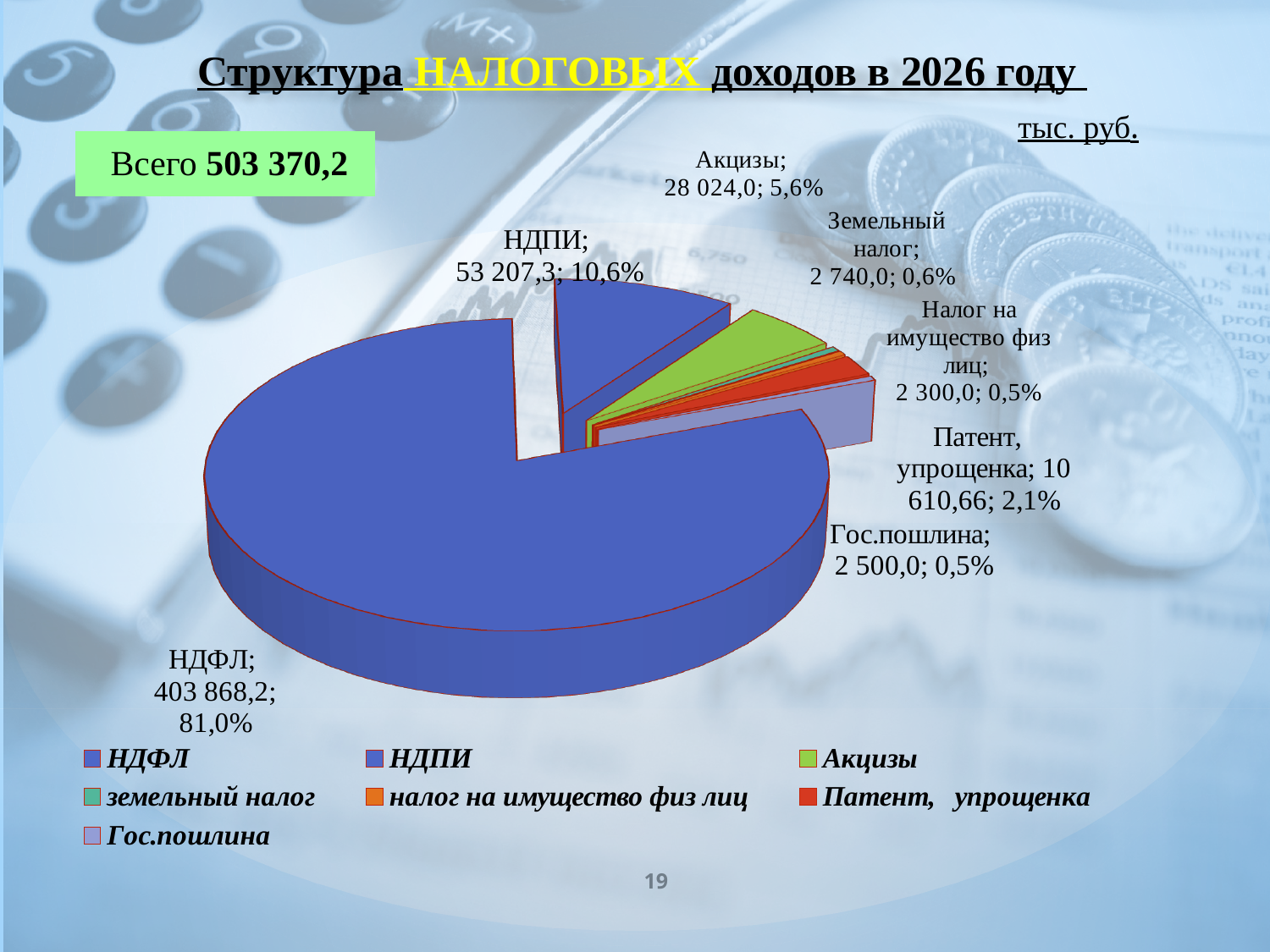
Which category has the largest slice of the pie? НДФЛ What total value is shown in the green box on the slide? 503 370,2 Which category has the smallest value? Налог на имущество физ лиц What share of the pie does Патент, упрощенка represent? 2,1% What type of chart is shown on the slide? Pie chart How many categories does the pie chart have? 7 Which is larger, the value for НДПИ or the value for Акцизы? НДПИ What is the value for НДФЛ? 403 868,2 What share of the pie does НДФЛ represent? 81,0% What is the value for НДПИ? 53 207,3 What is the difference between the values for Земельный налог and Гос.пошлина? 240,0 What is the value for Акцизы? 28 024,0